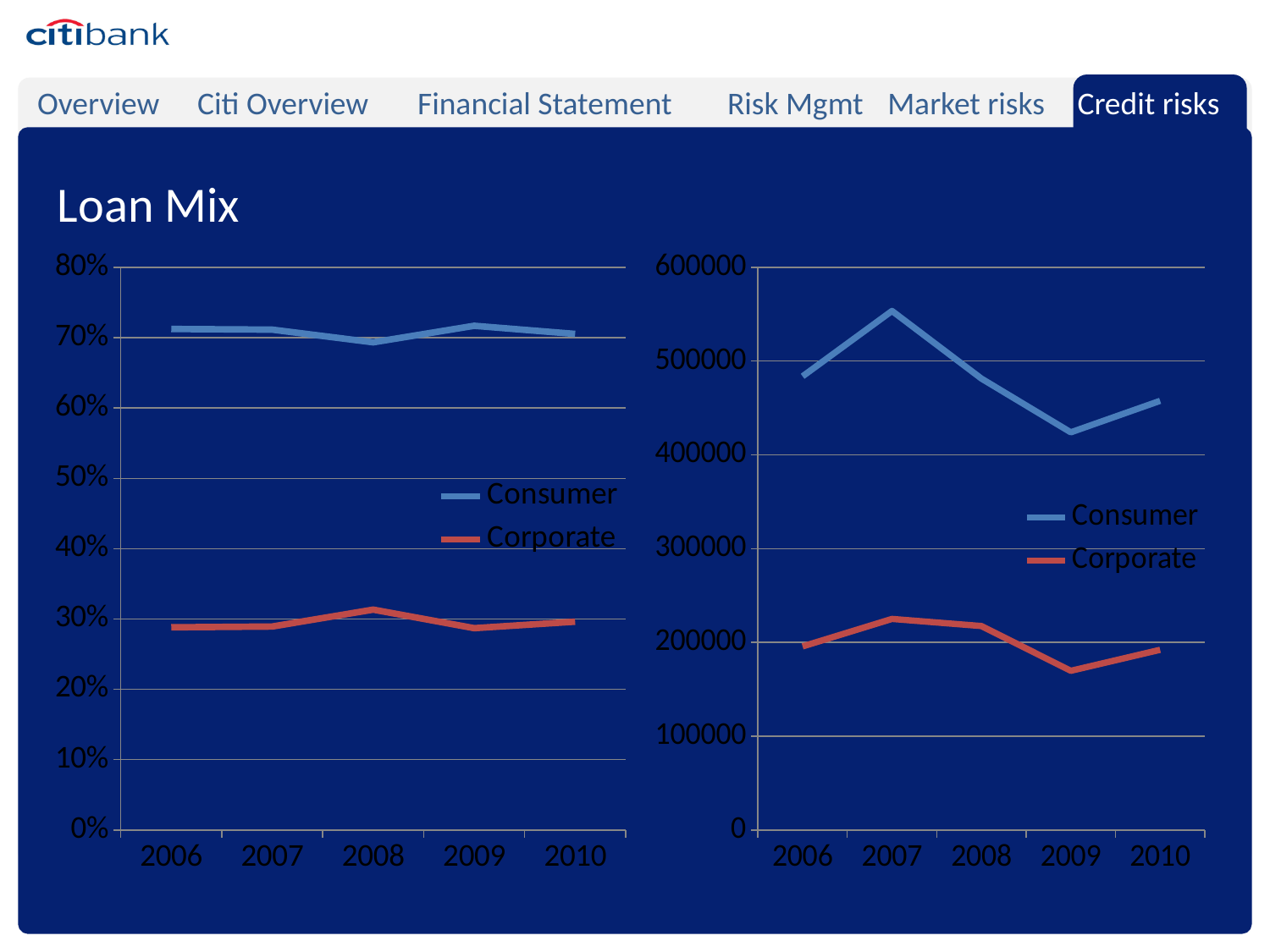
In the right chart, in which year is the Consumer value lowest? 2009 How many years are shown on the x axis of the left chart? 5 What kind of chart is the left chart on the slide? line chart In the right chart, is the Corporate value for 2009 greater or less than 200000? less In the left chart, which series has the larger value in 2010, Consumer or Corporate? Consumer In the right chart, in which year is the Consumer value highest? 2007 In the left chart, is the Consumer value for 2008 greater or less than 60%? greater In the right chart, is the Consumer value for 2007 greater or less than 500000? greater What is the title shown above the charts on the slide? Loan Mix In the right chart, does the Consumer value rise or fall from 2007 to 2009? fall In the right chart, in which year is the Corporate value lowest? 2009 How many series does the legend of the right chart list? 2